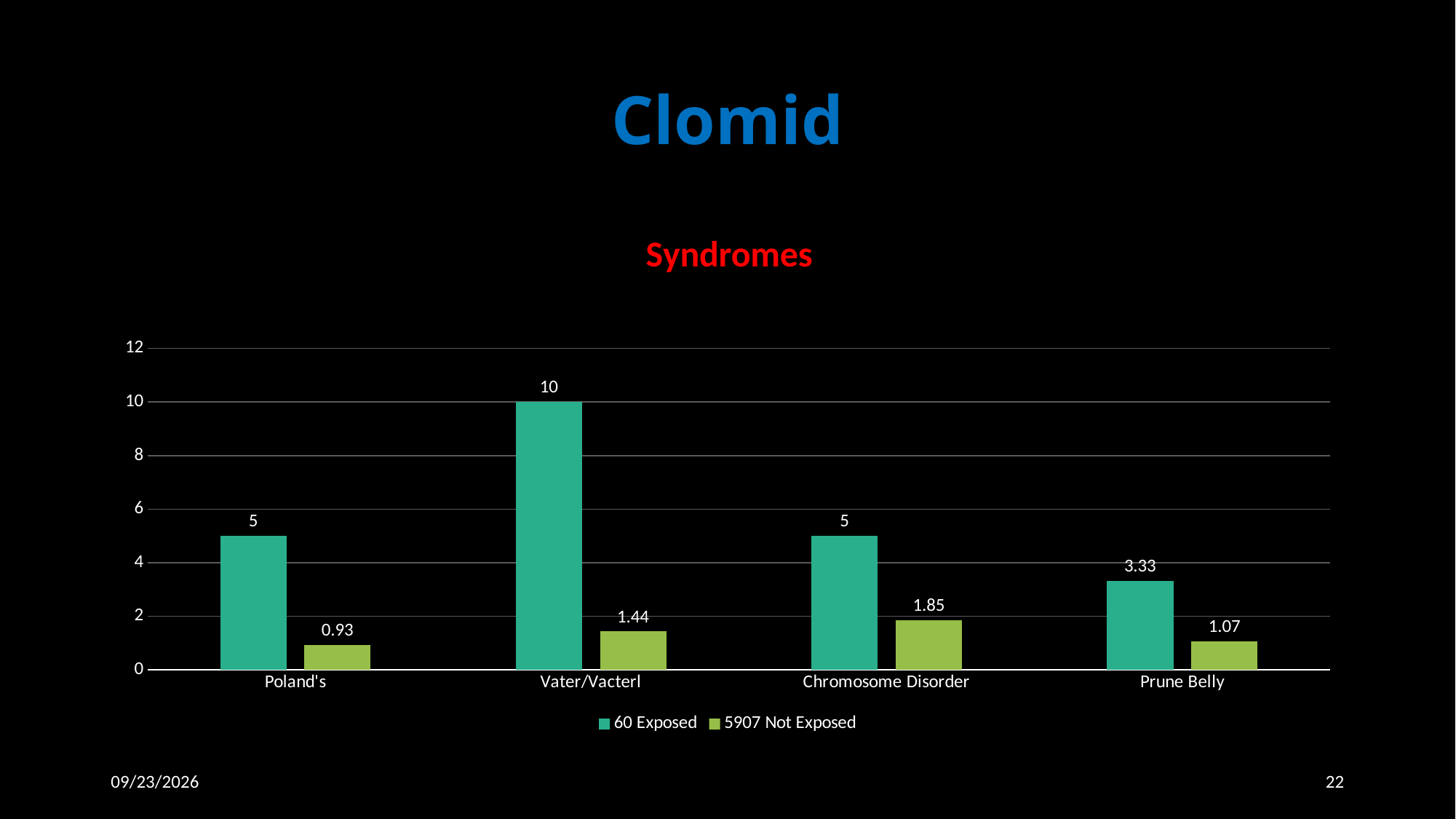
What is the value for 5907 Not Exposed for Poland's? 0.93 What kind of chart is shown on the slide? Bar chart What is the value for 60 Exposed for Prune Belly? 3.33 What is the value for 5907 Not Exposed for Chromosome Disorder? 1.85 What is the value for 60 Exposed for Vater/Vacterl? 10 What is the title of the chart? Syndromes What is the difference between the 60 Exposed and 5907 Not Exposed values for Vater/Vacterl? 8.56 How many syndromes are shown on the x axis? 4 Which syndrome has the lowest value for 5907 Not Exposed? Poland's Which is larger for Prune Belly: the 60 Exposed value or the 5907 Not Exposed value? 60 Exposed How many series does the legend list? 2 Which syndrome has the highest value for 60 Exposed? Vater/Vacterl